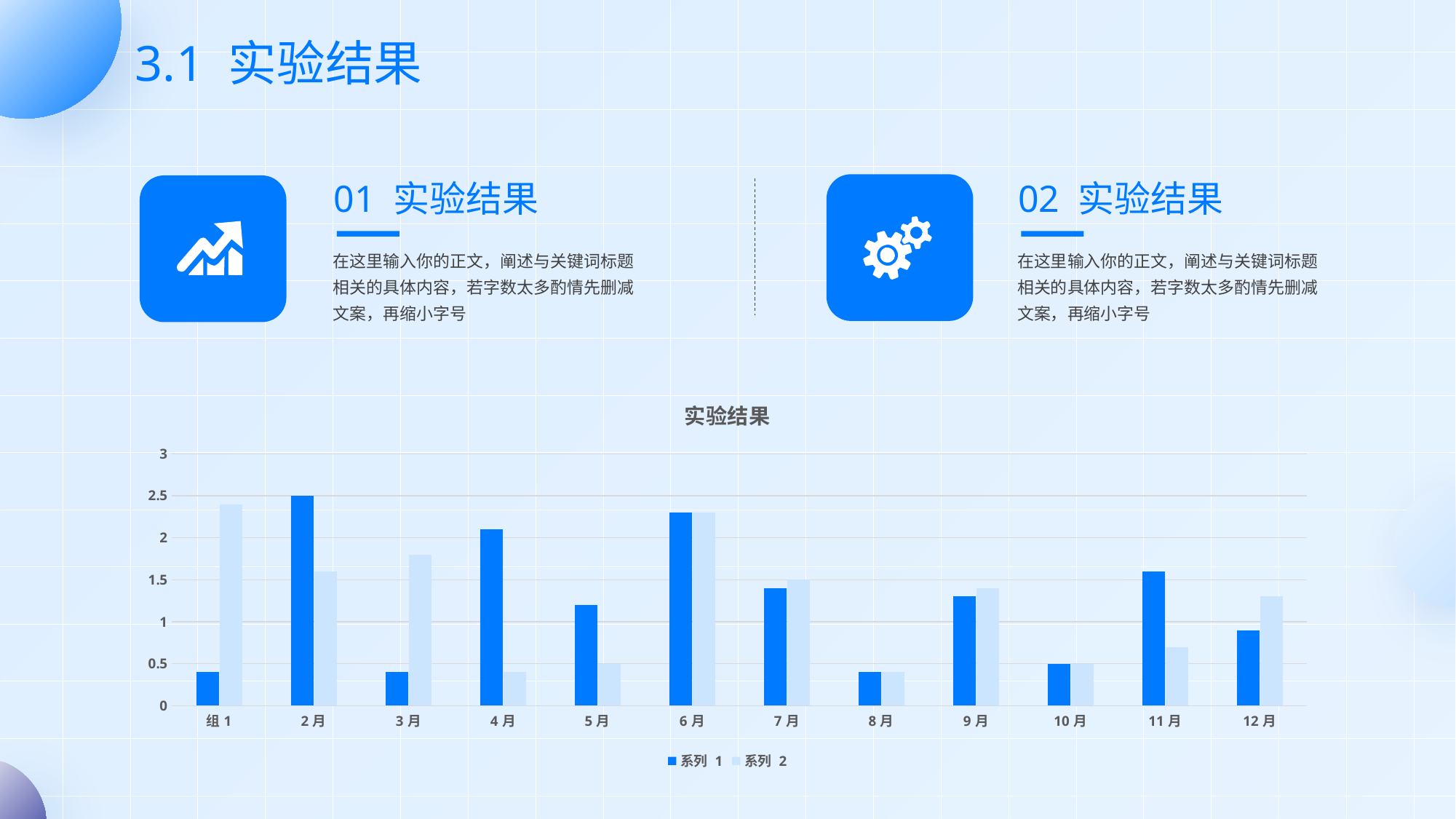
Is the value of 系列 1 for 6 月 greater or less than 2? greater What is the title of the chart? 实验结果 Which category has the highest value for 系列 1? 2 月 What kind of chart is shown on the slide? bar chart Is the value of 系列 1 for 组 1 greater or less than 0.5? less What is the value of 系列 1 for 10 月? 0.5 Is the value of 系列 2 for 3 月 greater or less than 1.5? greater How many series does the chart legend list? 2 For 11 月, which series has the larger value, 系列 1 or 系列 2? 系列 1 How many categories are shown on the x axis of the chart? 12 For 组 1, which series has the larger value, 系列 1 or 系列 2? 系列 2 What is the value of 系列 1 for 2 月? 2.5